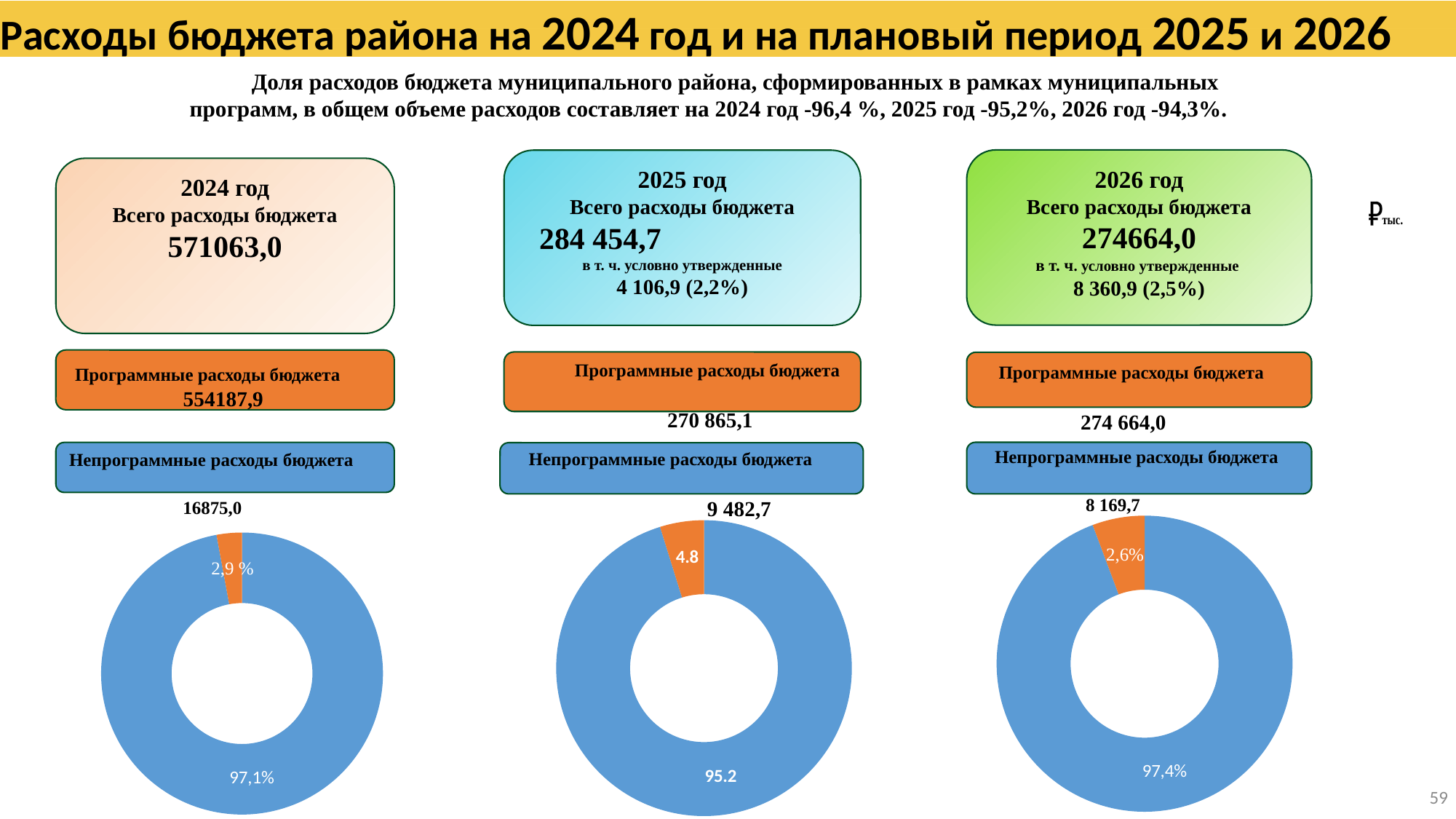
In the middle doughnut chart (2025), what value is shown on the large blue slice? 95.2 In the right doughnut chart (2026), what percentage is shown on the small orange slice? 2,6% In the middle doughnut chart (2025), what value is shown on the small orange slice? 4.8 In the left doughnut chart (2024), what percentage is shown on the small orange slice? 2,9 % What kind of chart is shown under the 2024 column on the left of the slide? Doughnut (pie) chart In the right doughnut chart (2026), what percentage is shown on the large blue slice? 97,4% In the left doughnut chart (2024), what percentage is shown on the large blue slice? 97,1% How many doughnut charts are shown on the slide? 3 How many slices does the left doughnut chart (2024) have? 2 Which slice is larger in the middle doughnut chart (2025), the blue one or the orange one? The blue one